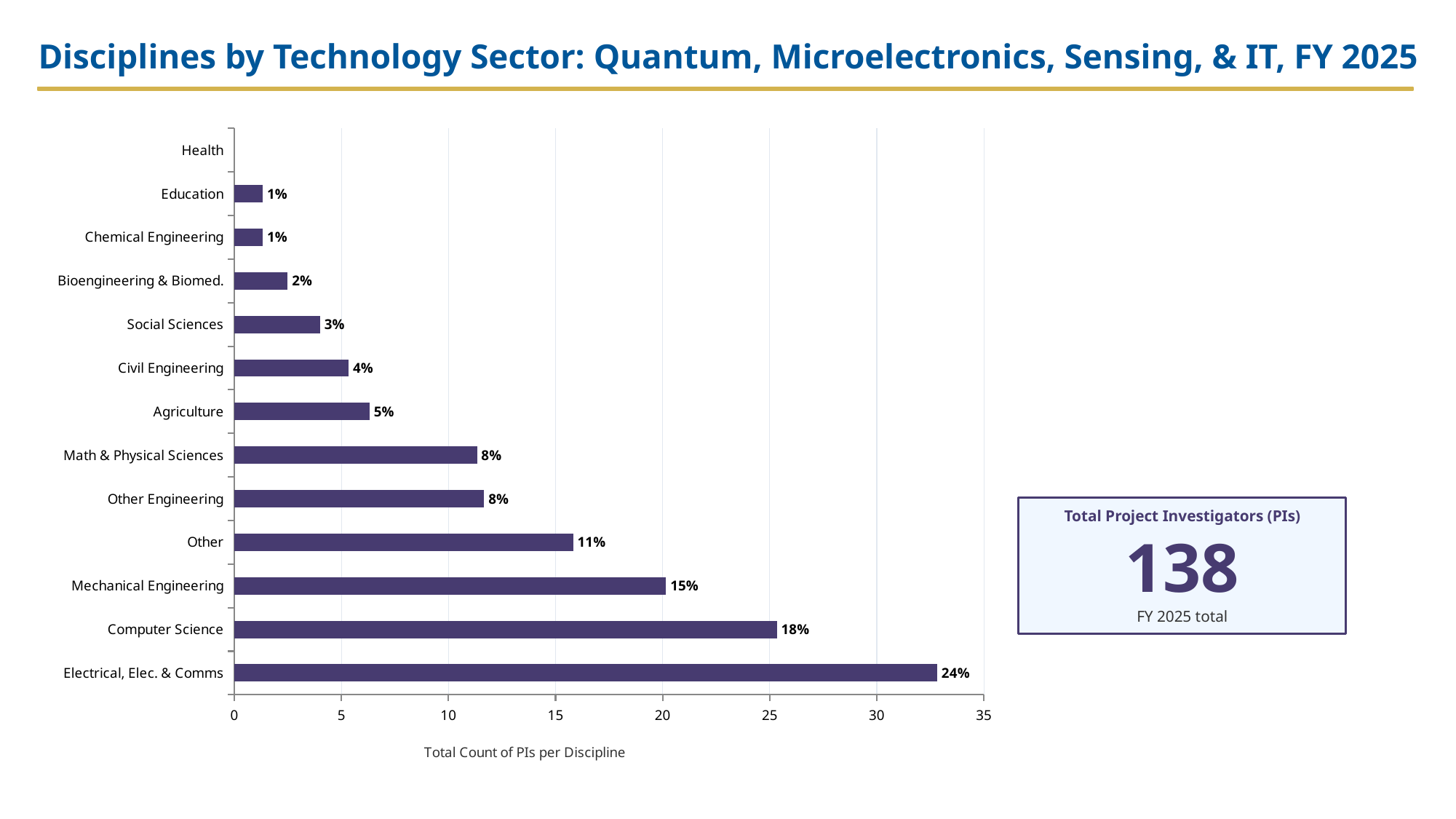
What percentage label is shown for Mechanical Engineering? 15% What is the total number of Project Investigators shown in the box on the slide? 138 Is the count of PIs for Electrical, Elec. & Comms greater or less than 30? greater What is the difference in percentage points between Electrical, Elec. & Comms and Computer Science? 6% What kind of chart is shown on the slide? Bar chart What percentage label is shown for Computer Science? 18% What percentage label is shown for Agriculture? 5% Is the count of PIs for Math & Physical Sciences greater or less than 10? greater How many disciplines are listed on the chart? 13 Which has a larger share, Mechanical Engineering or Other? Mechanical Engineering Which discipline has the highest count of PIs? Electrical, Elec. & Comms Which discipline has the lowest count of PIs? Health